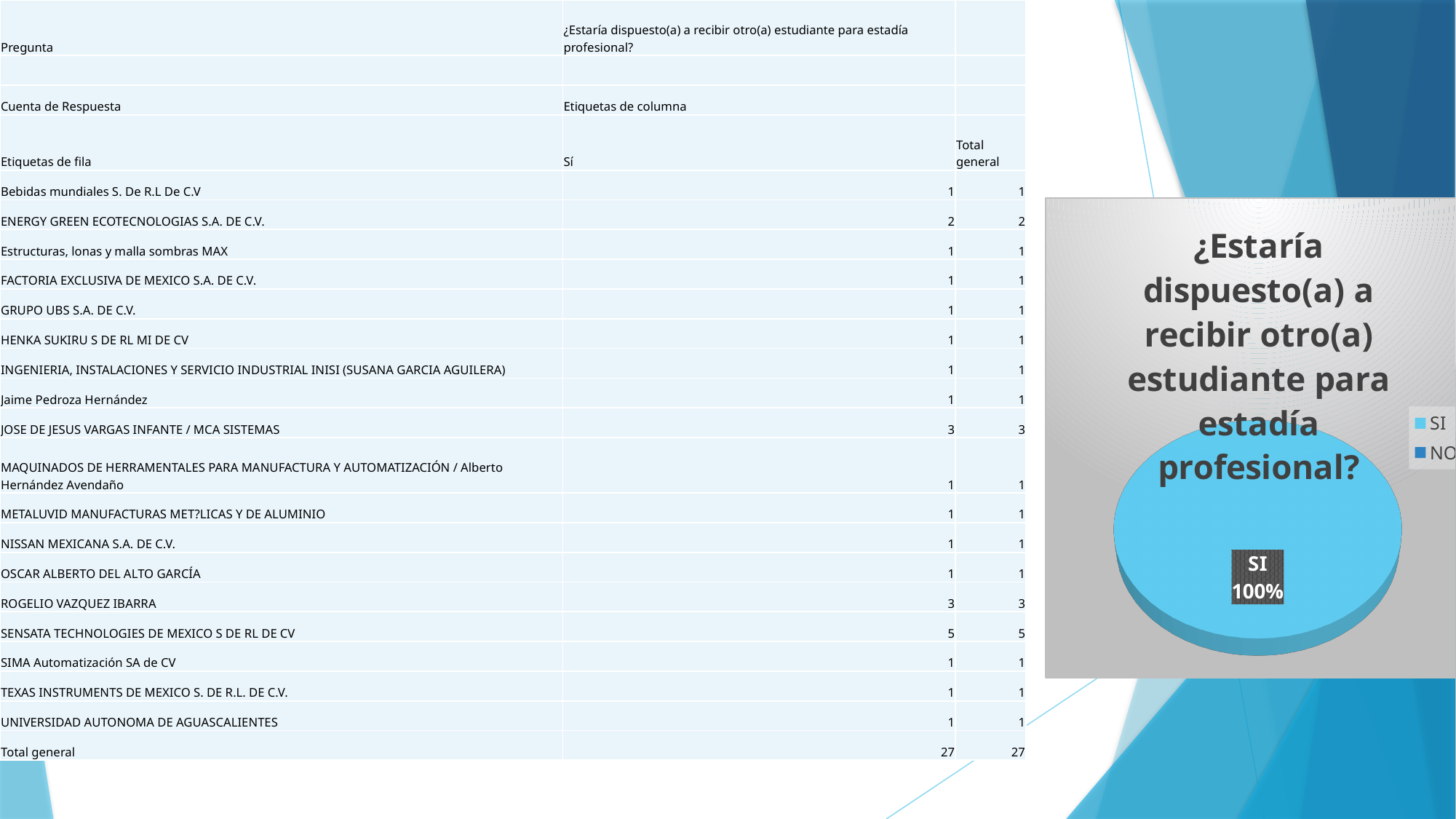
Which category has the largest share in the pie chart? SI How many slices are visible in the pie chart? 1 How many entries does the legend of the pie chart list? 2 What is the title of the pie chart? ¿Estaría dispuesto(a) a recibir otro(a) estudiante para estadía profesional? What kind of chart is shown on the slide? pie chart What are the legend entries of the pie chart? SI and NO What share of the pie chart does the SI slice represent? 100% What is the value printed on the data label of the pie chart? SI 100%